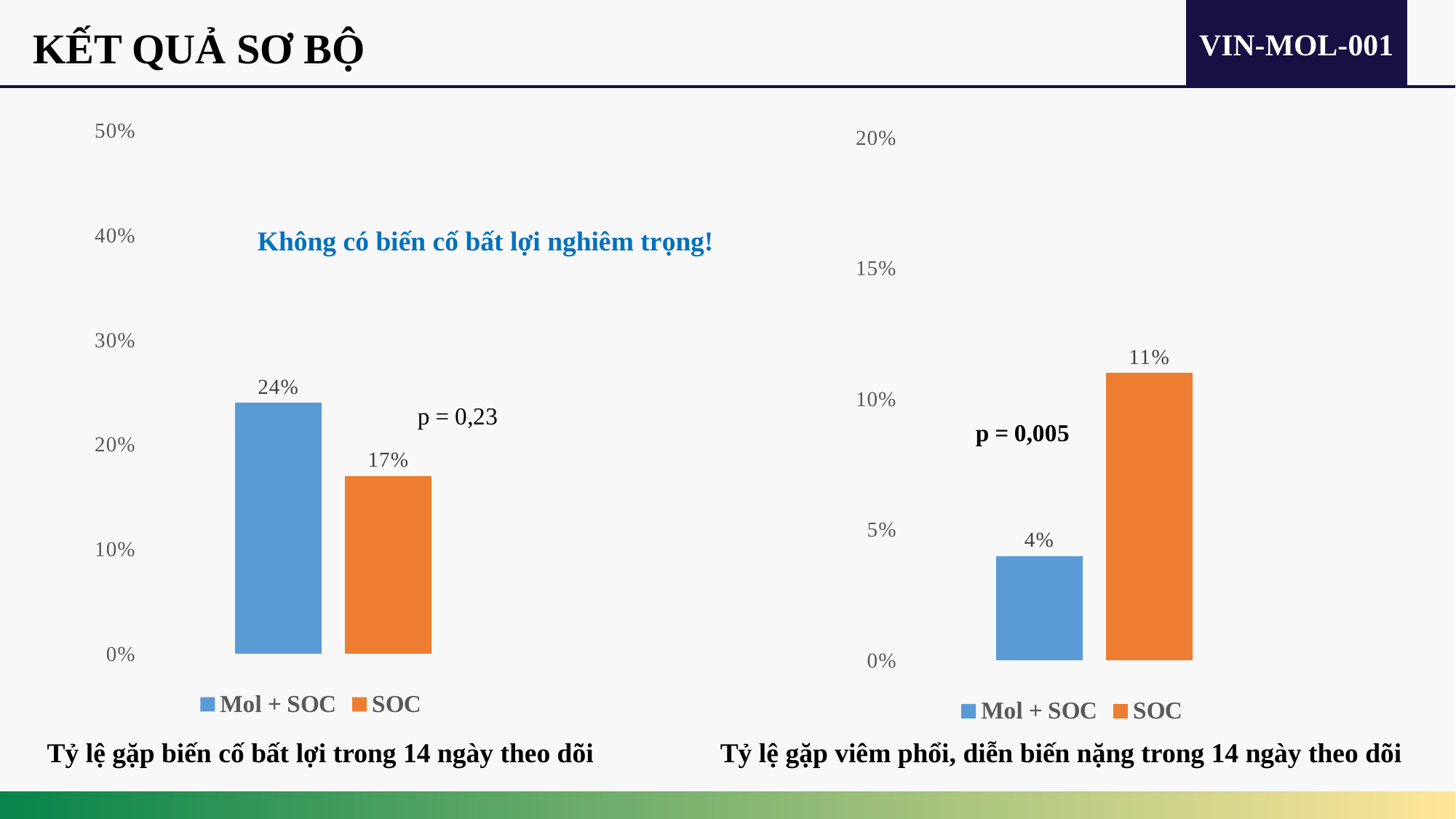
What p-value is shown on the right chart? p = 0,005 In the right chart, what is the difference between the SOC value and the Mol + SOC value? 7% In the right chart (Tỷ lệ gặp viêm phổi, diễn biến nặng trong 14 ngày theo dõi), what is the value for Mol + SOC? 4% In the left chart, what is the difference between the Mol + SOC value and the SOC value? 7% How many series does the legend of the left chart list? 2 In the right chart, is the value for SOC greater or less than 10%? greater In the right chart (Tỷ lệ gặp viêm phổi, diễn biến nặng trong 14 ngày theo dõi), what is the value for SOC? 11% In the left chart (Tỷ lệ gặp biến cố bất lợi trong 14 ngày theo dõi), what is the value for SOC? 17% What type of chart is the right chart? Bar chart In the left chart (Tỷ lệ gặp biến cố bất lợi trong 14 ngày theo dõi), what is the value for Mol + SOC? 24% In the left chart, which series has the higher value, Mol + SOC or SOC? Mol + SOC In the right chart, which series has the lower value? Mol + SOC